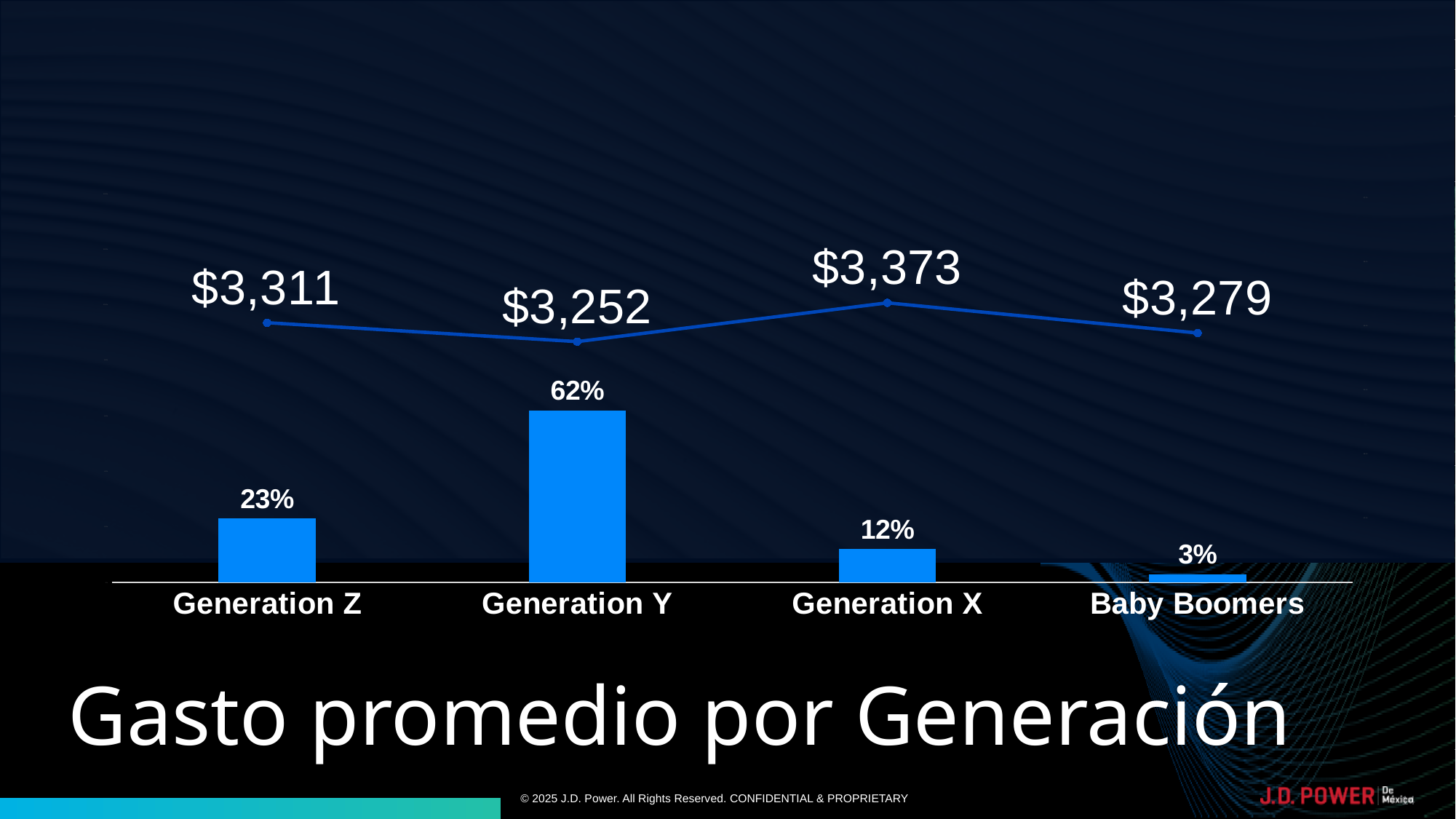
Which generation has the highest percentage bar? Generation Y Which is larger, the dollar value for Generation Z or for Baby Boomers? Generation Z Which generation has the highest dollar value on the line? Generation X What is the dollar value shown on the line for Generation Z? $3,311 What is the dollar value shown on the line for Generation X? $3,373 What is the difference in percentage points between Generation Z and Generation X? 11 What is the title of the slide? Gasto promedio por Generación What is the percentage value shown for Generation Y? 62% Which generation has the lowest dollar value on the line? Generation Y How many generation categories are shown on the x axis? 4 What is the percentage value shown for Baby Boomers? 3% What is the difference between the dollar values for Generation X and Generation Y? $121